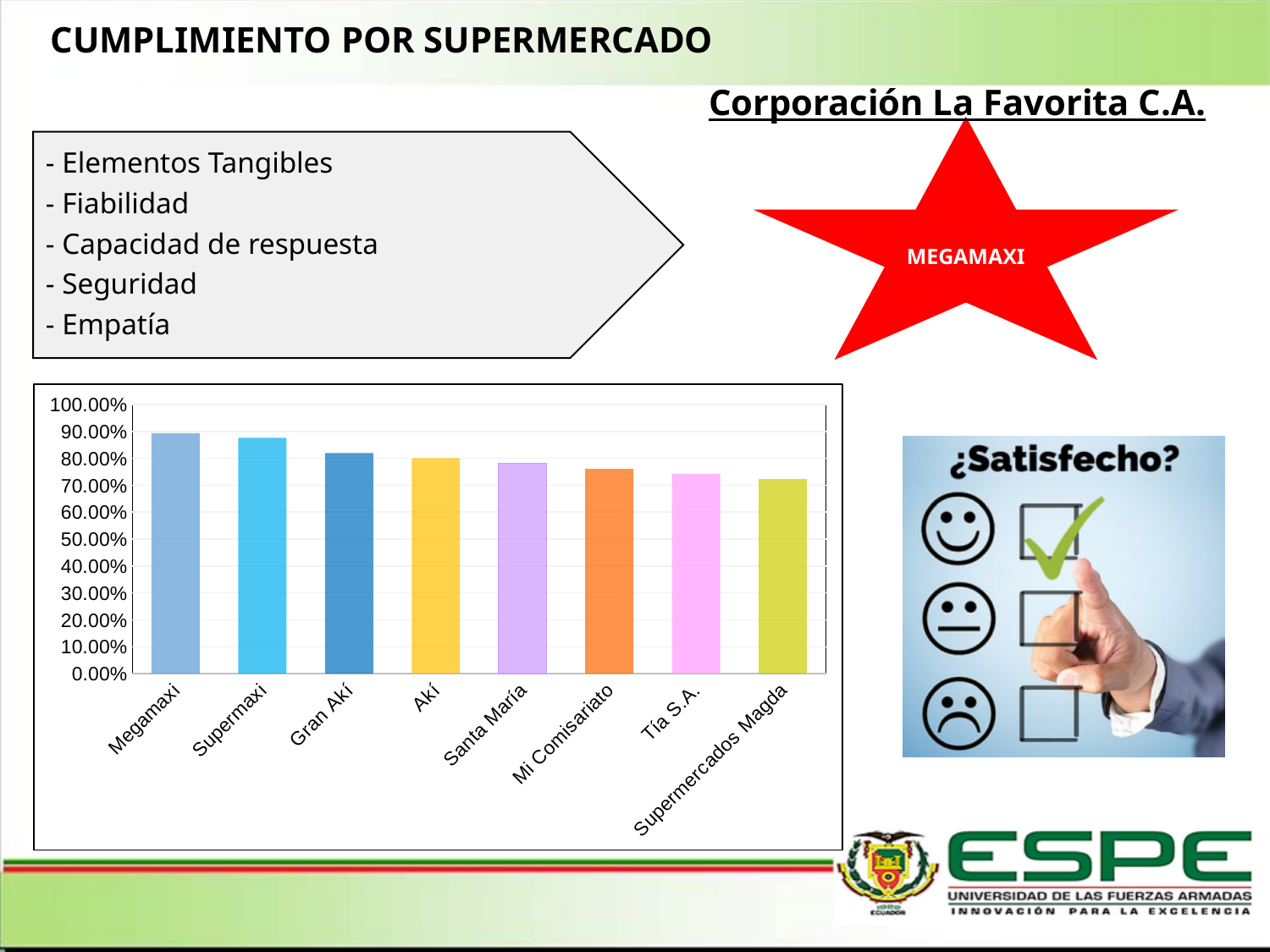
Is the value for Supermercados Magda greater or less than 80.00%? less Is the value for Megamaxi greater or less than 80.00%? greater Which has the larger value, Gran Akí or Tía S.A.? Gran Akí Is the value for Tía S.A. greater or less than 90.00%? less What kind of chart is shown on the slide? bar chart Which has the larger value, Supermaxi or Santa María? Supermaxi Which has the larger value, Megamaxi or Supermercados Magda? Megamaxi Do the bar values rise or fall from left to right along the x axis? fall How many supermarkets are shown on the x axis of the chart? 8 What is the highest value shown on the chart's y axis? 100.00%